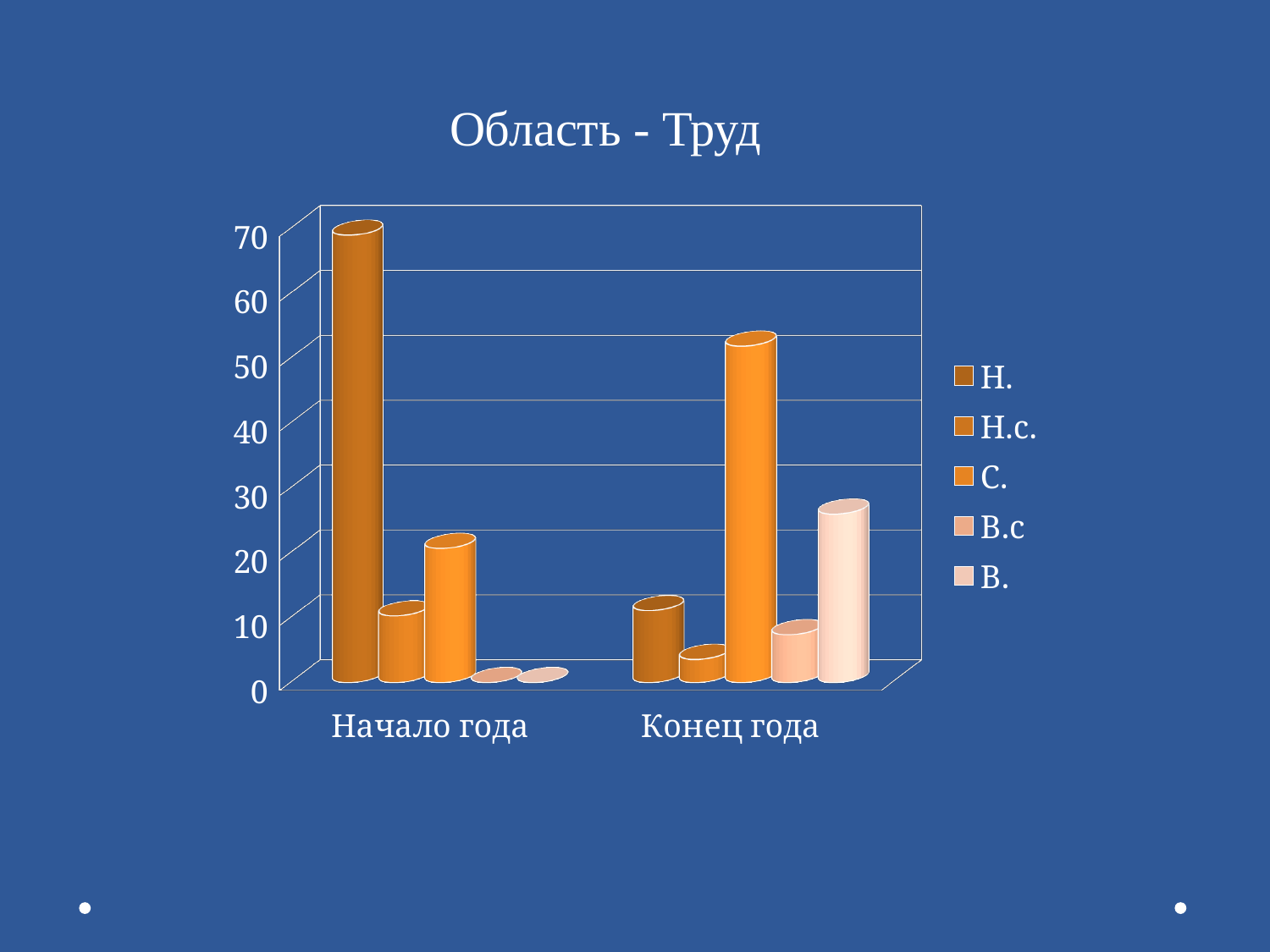
Does the value for С. rise or fall from Начало года to Конец года? rise Which series has the highest value for Начало года? Н. How many series does the legend list? 5 What is the title of the chart? Область - Труд Is the value for С. at Конец года greater or less than 40? greater Is the value for Н.с. at Начало года greater or less than 20? less How many categories are shown on the x axis? 2 Which series has the lowest value for Конец года? Н.с. Which series has the highest value for Конец года? С. Which is larger: the value for Н. at Начало года or the value for Н. at Конец года? Начало года Is the value for Н. at Начало года greater or less than 50? greater What kind of chart is shown on the slide? Bar chart